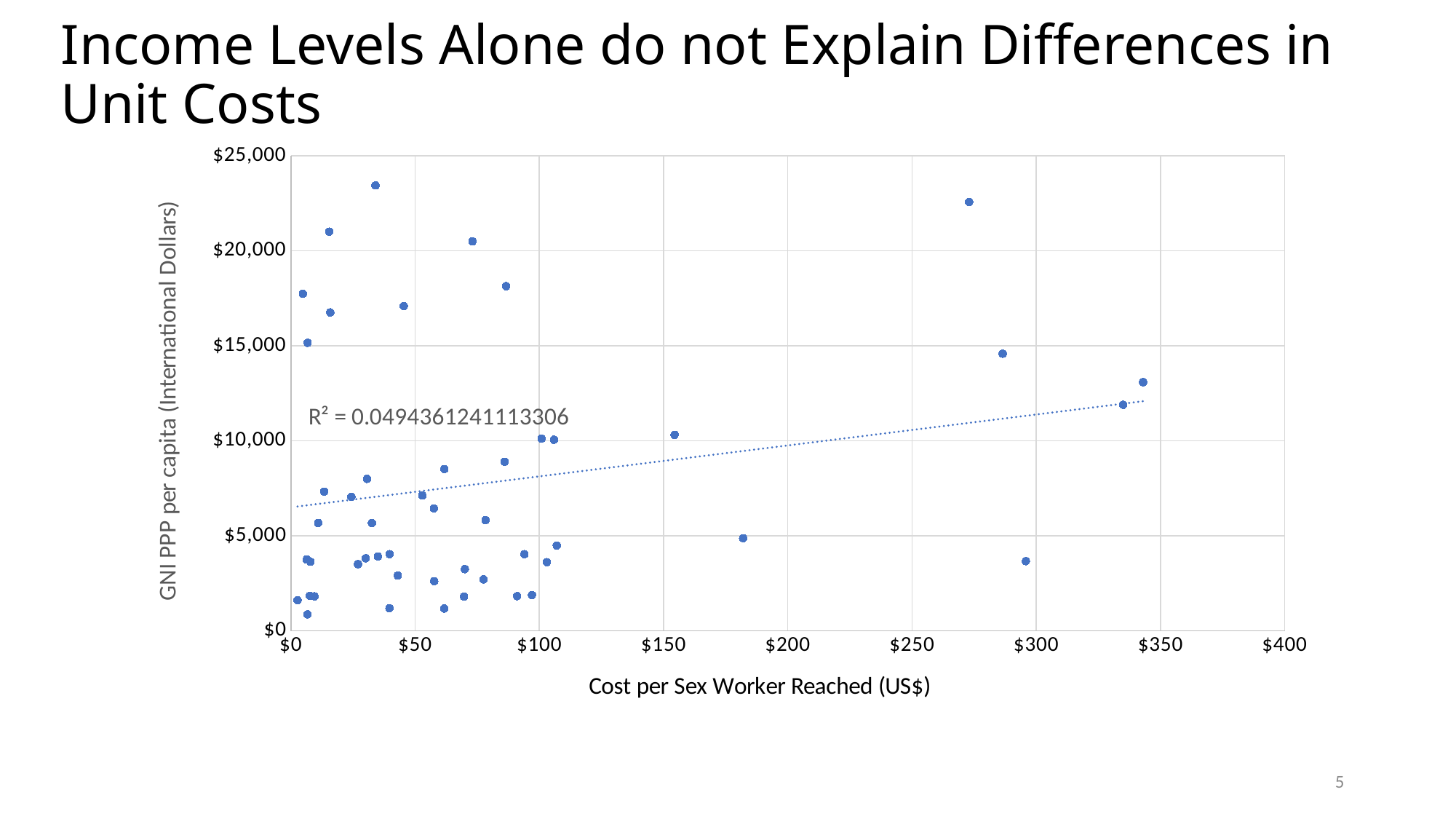
Is the GNI PPP per capita for the point with the highest GNI PPP per capita greater or less than $20,000? greater What R² value is printed on the chart? 0.0494361241113306 Is the cost per sex worker reached for the point with the highest GNI PPP per capita greater or less than $50? less Is the GNI PPP per capita for the point with the highest cost per sex worker reached greater or less than $10,000? greater What kind of chart is shown on the slide? Scatter chart What is the title of the x axis of the chart? Cost per Sex Worker Reached (US$) Does the dotted trendline on the chart rise or fall as cost per sex worker reached increases? Rise What is the maximum value shown on the x axis of the chart? $400 What is the title of the y axis of the chart? GNI PPP per capita (International Dollars)